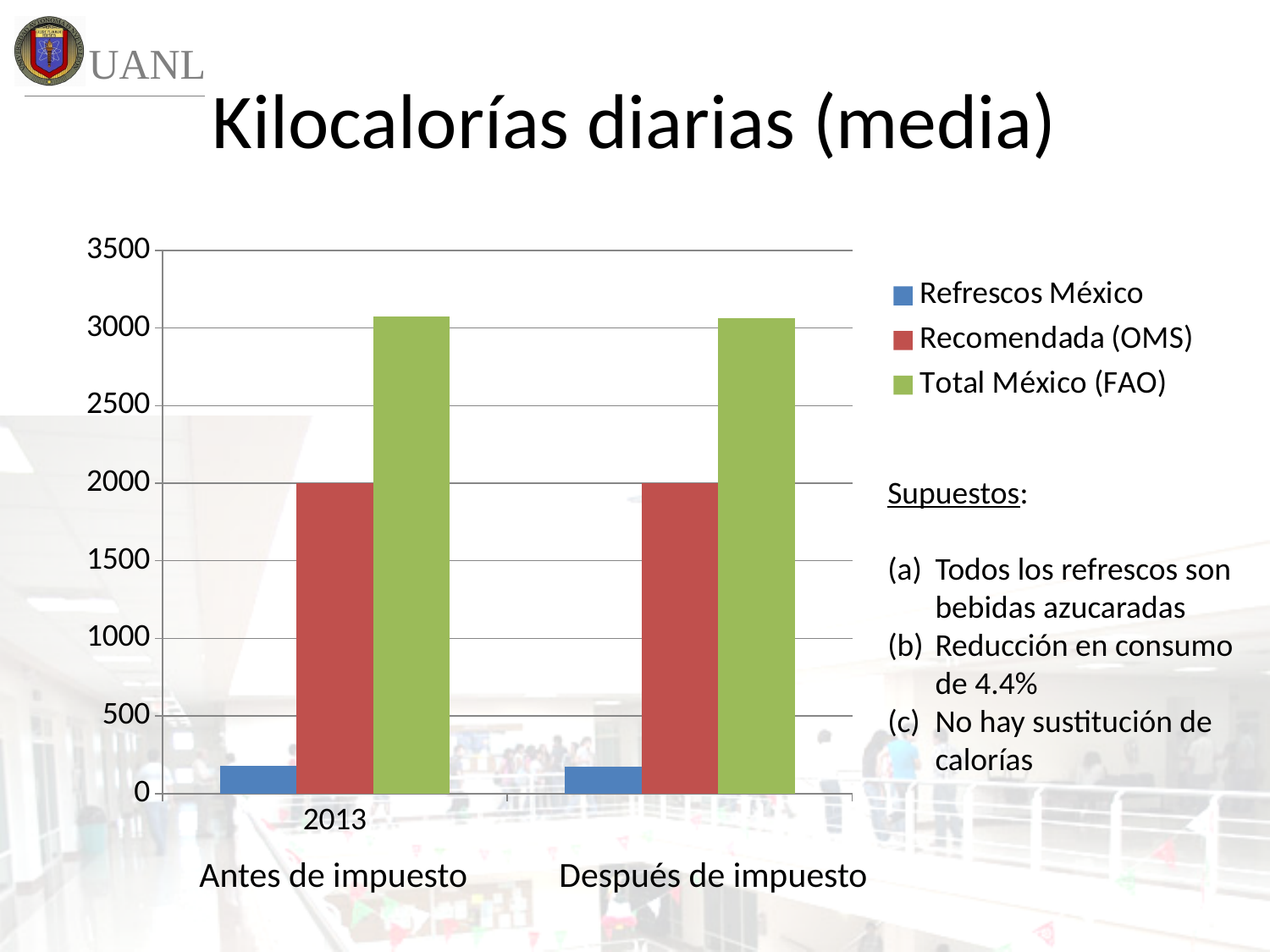
What is the value for Recomendada (OMS) in the Después de impuesto group? 2000 Which colour represents the Total México (FAO) series? green What is the value for Recomendada (OMS) in the Antes de impuesto group? 2000 What kind of chart is shown on the slide? bar chart How many series does the legend list? 3 Which series has the lowest value in the Después de impuesto group? Refrescos México How many category groups are shown on the x axis? 2 In the Antes de impuesto group, which is larger: Recomendada (OMS) or Refrescos México? Recomendada (OMS) Is the value for Refrescos México in the Después de impuesto group greater or less than 500? less Which series has the highest value in the Antes de impuesto group? Total México (FAO) What is the title of the chart? Kilocalorías diarias (media) Is the value for Total México (FAO) in the Antes de impuesto group greater or less than 3000? greater